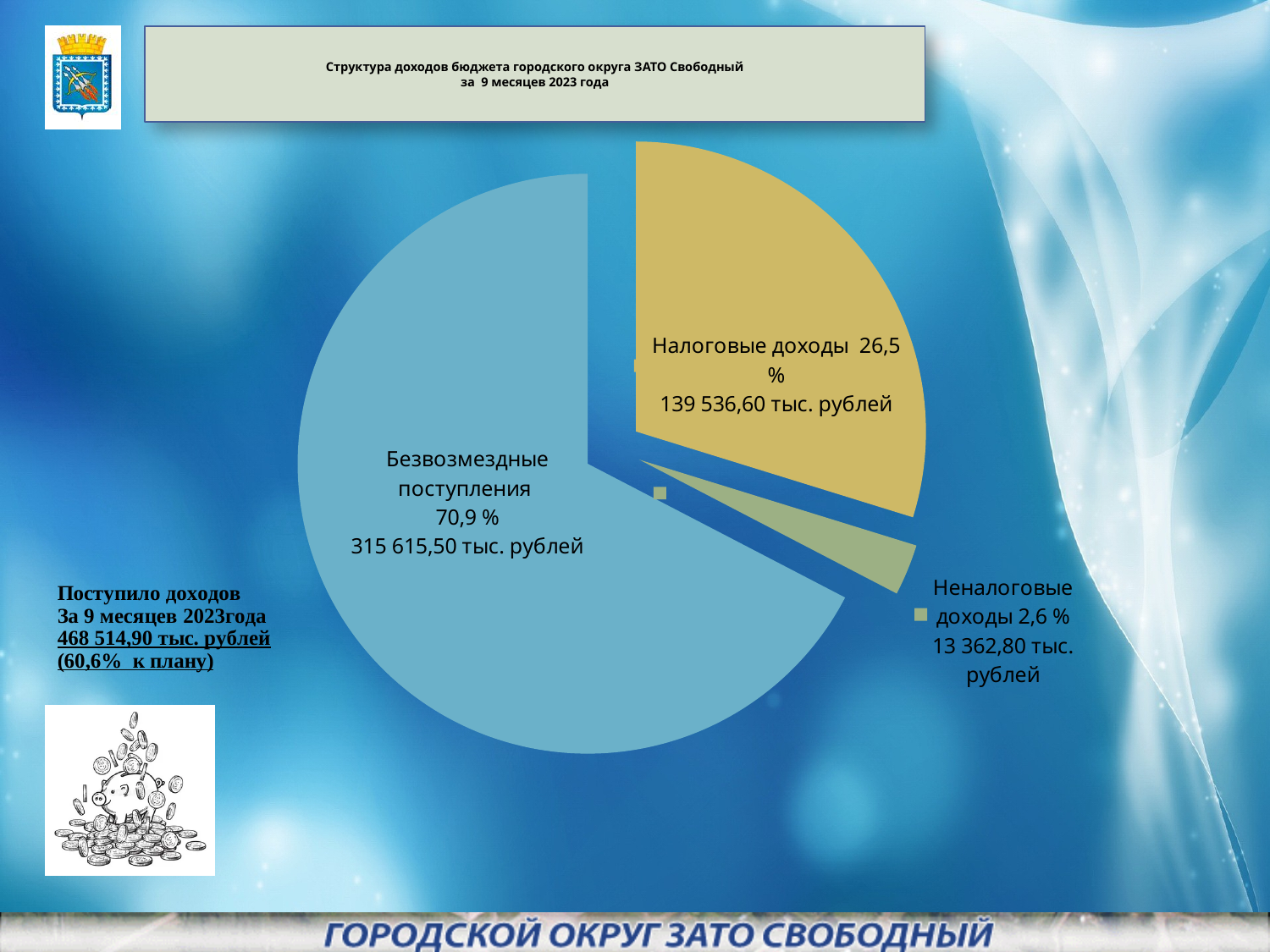
What share of the pie does Безвозмездные поступления represent? 70,9 % What is the value shown for Неналоговые доходы in thousand rubles? 13 362,80 тыс. рублей Which is larger, Налоговые доходы or Неналоговые доходы? Налоговые доходы What share of the pie does Неналоговые доходы represent? 2,6 % What is the value shown for Налоговые доходы in thousand rubles? 139 536,60 тыс. рублей What kind of chart is shown on the slide? Pie chart Which category has the largest slice of the pie? Безвозмездные поступления What is the difference in percentage points between the shares of Безвозмездные поступления and Налоговые доходы? 44,4 What is the value shown for Безвозмездные поступления in thousand rubles? 315 615,50 тыс. рублей Which category has the smallest slice of the pie? Неналоговые доходы What share of the pie does Налоговые доходы represent? 26,5 % How many slices does the pie chart have? 3